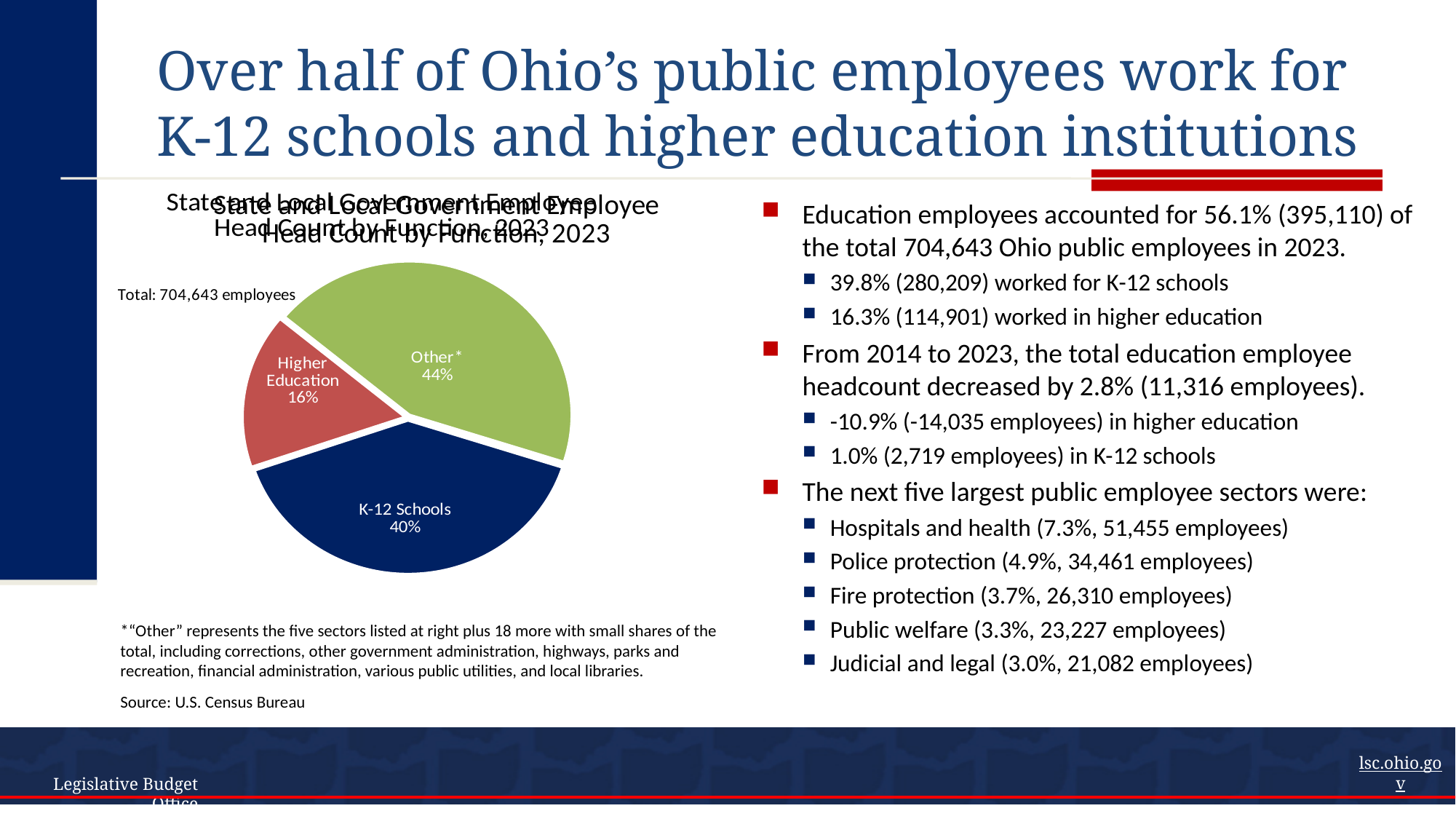
What colour is the K-12 Schools slice of the pie chart? dark blue What total number of employees is stated next to the pie chart? 704,643 employees What share of the pie does Higher Education represent? 16% What share of the pie does K-12 Schools represent? 40% Which is larger, the K-12 Schools slice or the Higher Education slice? K-12 Schools Which slice of the pie chart is the largest? Other* Which slice of the pie chart is the smallest? Higher Education What kind of chart is shown on the slide? pie chart What share of the pie does the Other* slice represent? 44% What is the title of the pie chart? State and Local Government Employee Head Count by Function, 2023 What is the difference in percentage points between the K-12 Schools slice and the Higher Education slice? 24 percentage points How many slices does the pie chart have? 3